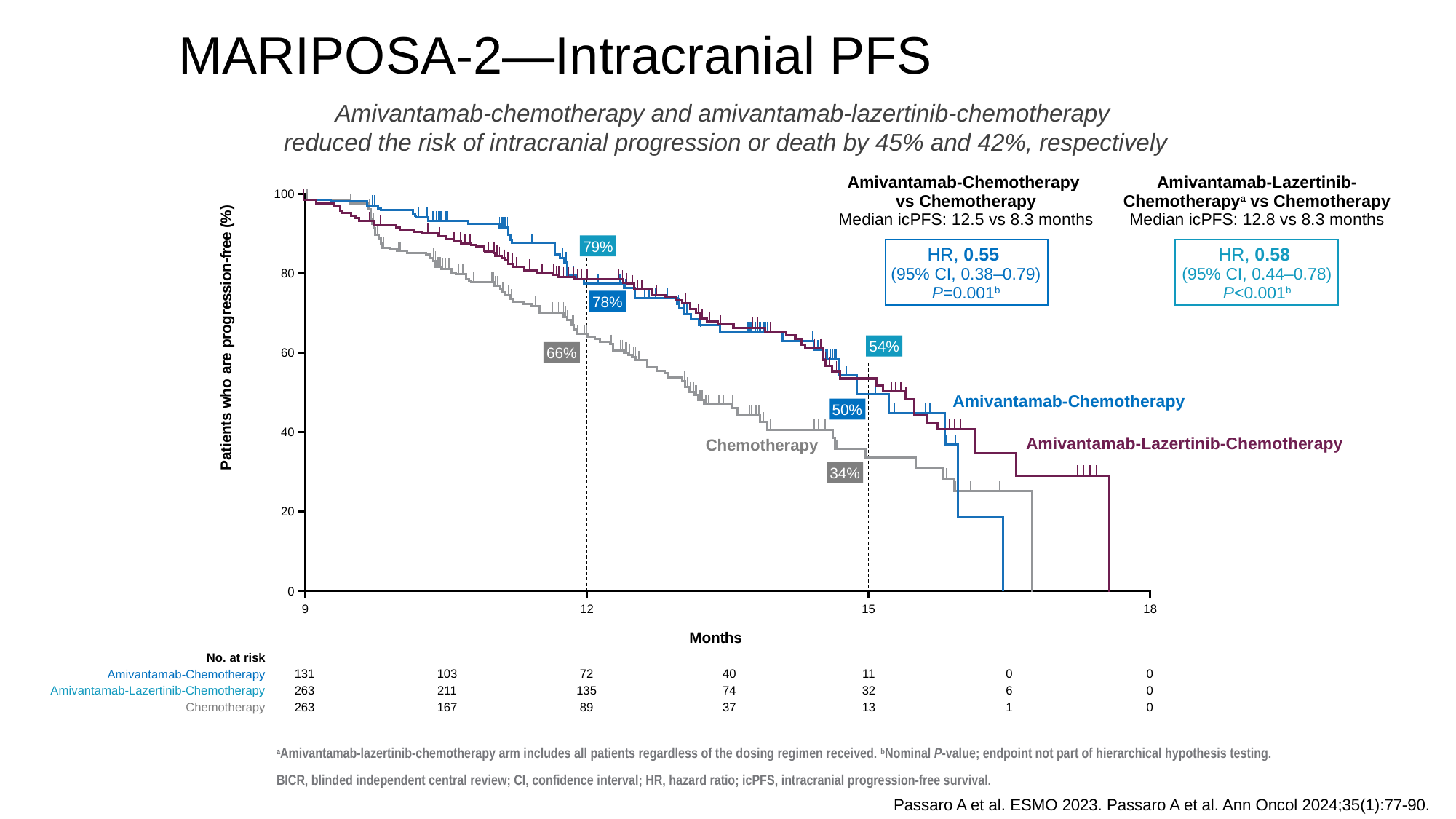
How many treatment arms (curves) are plotted on the chart? 3 How many Chemotherapy patients were at risk at 12 months? 89 By how many percentage points did the Chemotherapy progression-free rate drop between the 12-month and 15-month labels? 32 percentage points What percentage of Chemotherapy patients were progression-free at 12 months, according to the data label? 66% Do the curves rise or fall as months increase along the x axis? fall What percentage of Chemotherapy patients were progression-free at 15 months, according to the data label? 34% Which arm has the lowest curve (lowest progression-free percentage) at 15 months? Chemotherapy What kind of chart is shown on the slide? Kaplan-Meier survival curve (line chart) What is the hazard ratio for Amivantamab-Lazertinib-Chemotherapy vs Chemotherapy? 0.58 What is the median icPFS for Amivantamab-Chemotherapy vs Chemotherapy? 12.5 vs 8.3 months How many Amivantamab-Chemotherapy patients were at risk at 9 months? 131 How many Amivantamab-Lazertinib-Chemotherapy patients were at risk at 15 months? 32